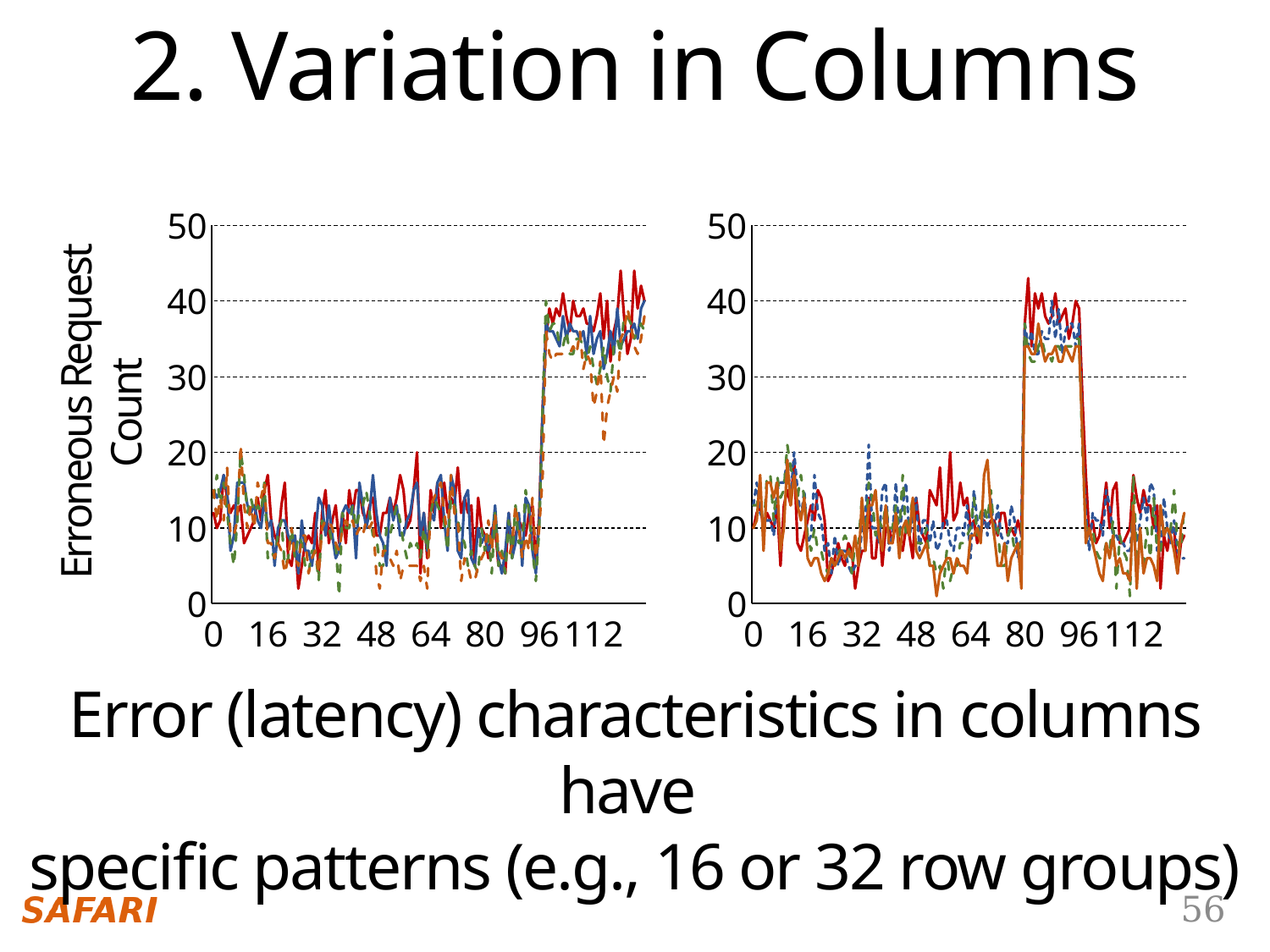
In the left chart, are the values around x = 104 greater or less than 30? greater In the right chart, are the values around x = 88 greater or less than 30? greater In the right chart, are the values around x = 88 higher or lower than the values around x = 112? higher What kind of chart is shown on the right of the slide? line chart What kind of chart is shown on the left of the slide? line chart In the left chart, do the values rise or fall sharply just after x = 96? rise In the left chart, are the values around x = 48 greater or less than 20? less What is the y-axis label of the left chart? Erroneous Request Count In the right chart, do the values rise or fall sharply just after x = 96? fall In the left chart, are the values around x = 112 higher or lower than the values around x = 16? higher How many charts are shown on the slide? 2